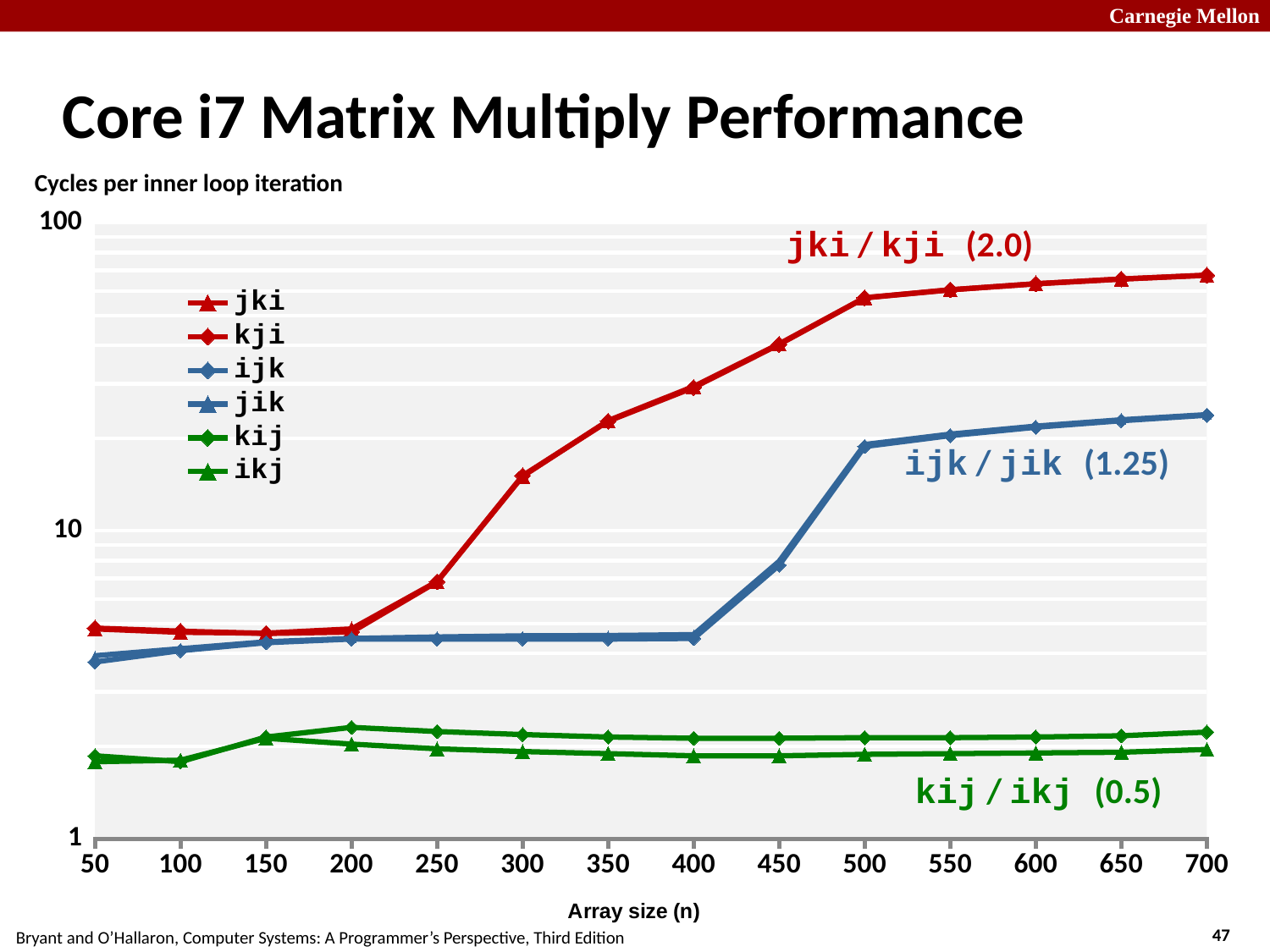
What kind of chart is shown on the slide? line chart What is the label of the x axis? Array size (n) Is the value for jki at array size 700 greater or less than 10? greater How many series does the legend list? 6 What is the title of the chart? Core i7 Matrix Multiply Performance Which is larger for the ijk series, the value at array size 400 or at array size 500? 500 Which is larger at array size 700, the value for jki or the value for ijk? jki Does the jki series rise or fall as array size increases from 200 to 700? rise Is the value for kij at array size 700 greater or less than 10? less Is the value for jki at array size 700 greater or less than 100? less How many array sizes (x-axis points) are plotted for each series? 14